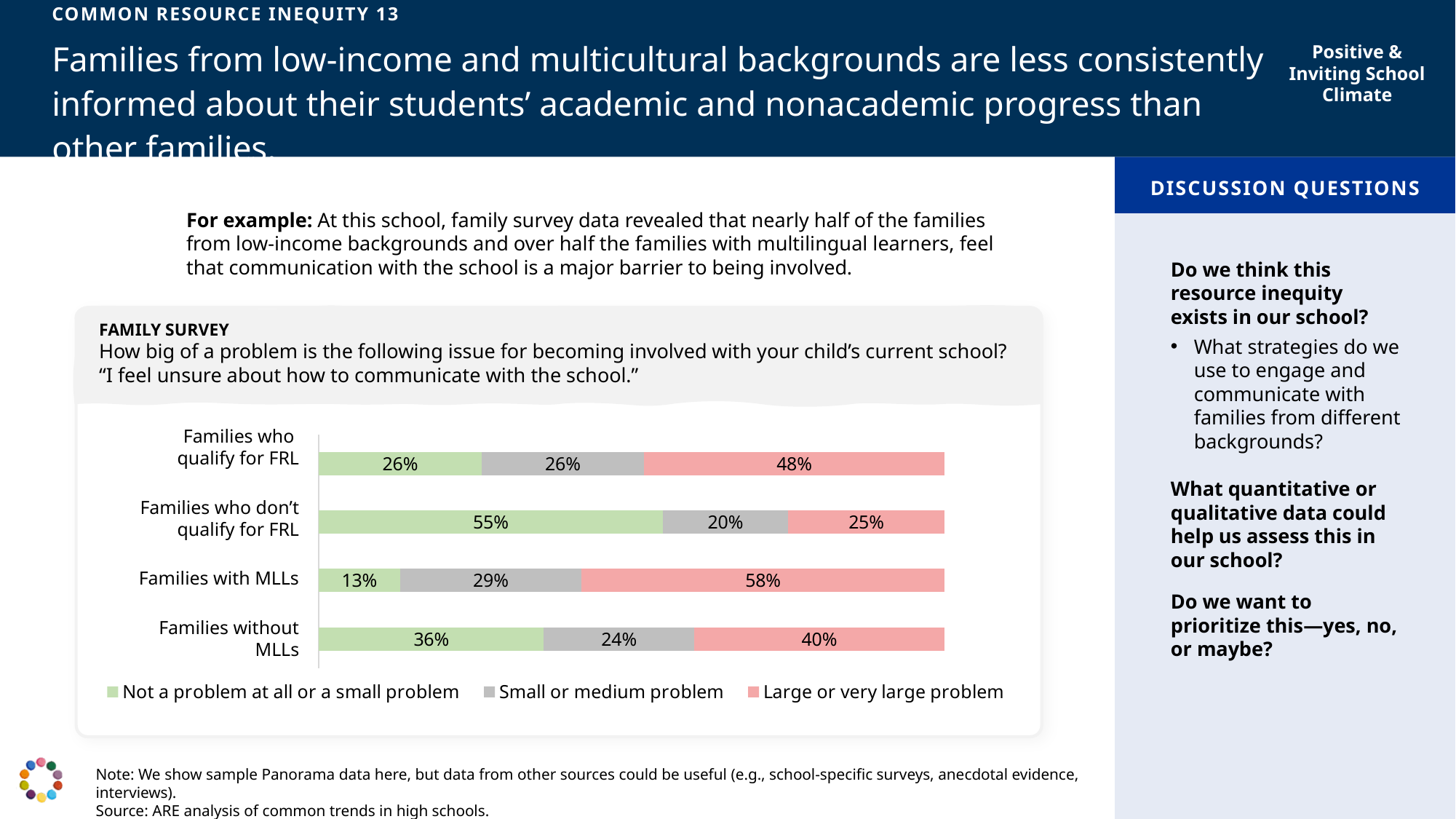
What percentage of families with MLLs reported a large or very large problem? 58% What percentage of families who don't qualify for FRL reported not a problem at all or a small problem? 55% How many series does the chart legend list? 3 Which is larger: the large or very large problem share for families without MLLs or for families who qualify for FRL? Families who qualify for FRL Which colour represents the 'Large or very large problem' series in the legend? Pink/red What kind of chart is shown on the slide? Stacked bar chart How many family groups (categories) are shown in the chart? 4 Which family group has the highest share reporting a large or very large problem? Families with MLLs What is the total of the three segments for the families without MLLs bar? 100% Which family group has the lowest share reporting not a problem at all or a small problem? Families with MLLs What is the difference between the large or very large problem share for families who qualify for FRL and families who don't qualify for FRL? 23 percentage points What percentage of families who qualify for FRL reported a small or medium problem? 26%